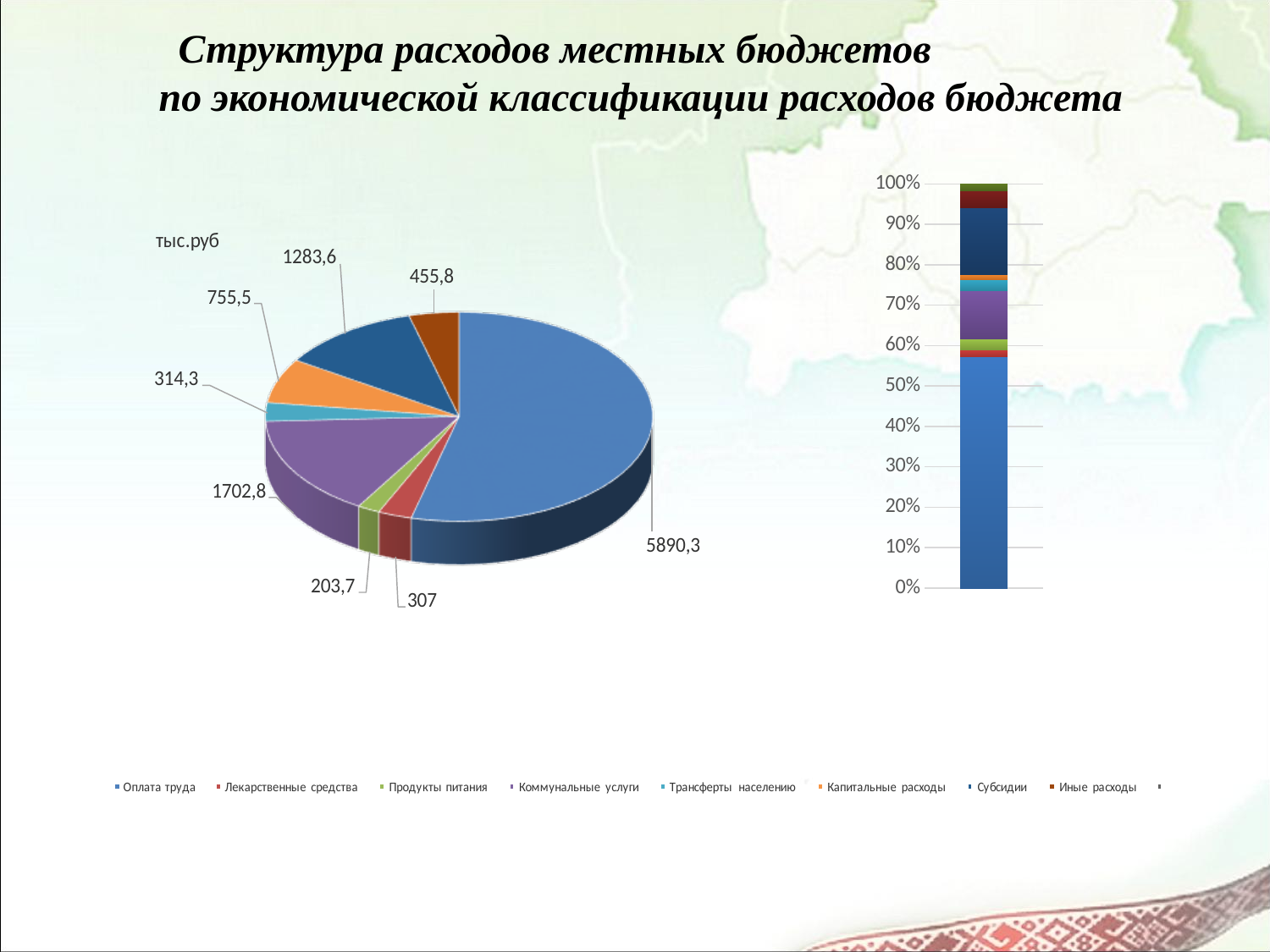
On the pie chart on the left, what is the value for Оплата труда? 5890,3 On the pie chart on the left, what is the difference between Субсидии and Капитальные расходы? 528,1 What unit is shown next to the pie chart on the left? тыс.руб On the pie chart on the left, which is larger: Иные расходы or Трансферты населению? Иные расходы On the pie chart on the left, which category has the smallest value? Продукты питания On the pie chart on the left, what is the difference between Оплата труда and Коммунальные услуги? 4187,5 On the pie chart on the left, what is the value for Продукты питания? 203,7 On the pie chart on the left, what is the value for Коммунальные услуги? 1702,8 On the pie chart on the left, what is the value for Субсидии? 1283,6 How many labelled slices does the pie chart on the left have? 8 On the stacked bar chart on the right, is the top of the Оплата труда segment greater or less than 50%? greater On the pie chart on the left, which category has the largest value? Оплата труда